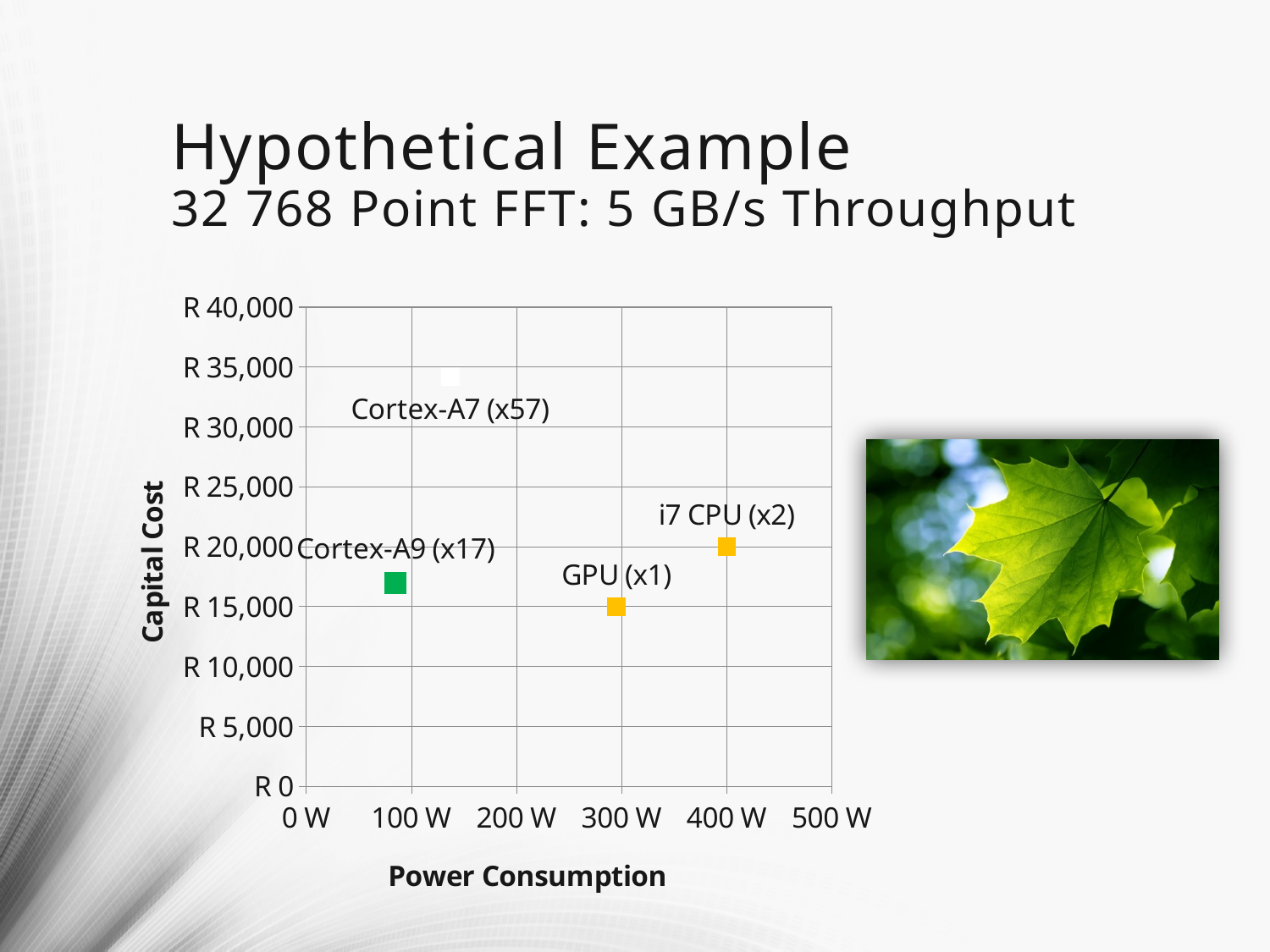
What kind of chart is shown on the slide? scatter chart How many data points are plotted on the chart? 4 Which point has the lowest capital cost? GPU (x1) What is the difference in capital cost between i7 CPU (x2) and GPU (x1)? R 5,000 Is the capital cost for Cortex-A7 (x57) greater or less than R 30,000? greater Which point has the highest power consumption? i7 CPU (x2) Which point has the lowest power consumption? Cortex-A9 (x17) Which point has the highest capital cost? Cortex-A7 (x57) What is the capital cost of the i7 CPU (x2) point? R 20,000 Is the power consumption for Cortex-A9 (x17) greater or less than 100 W? less What is the title of the x axis? Power Consumption